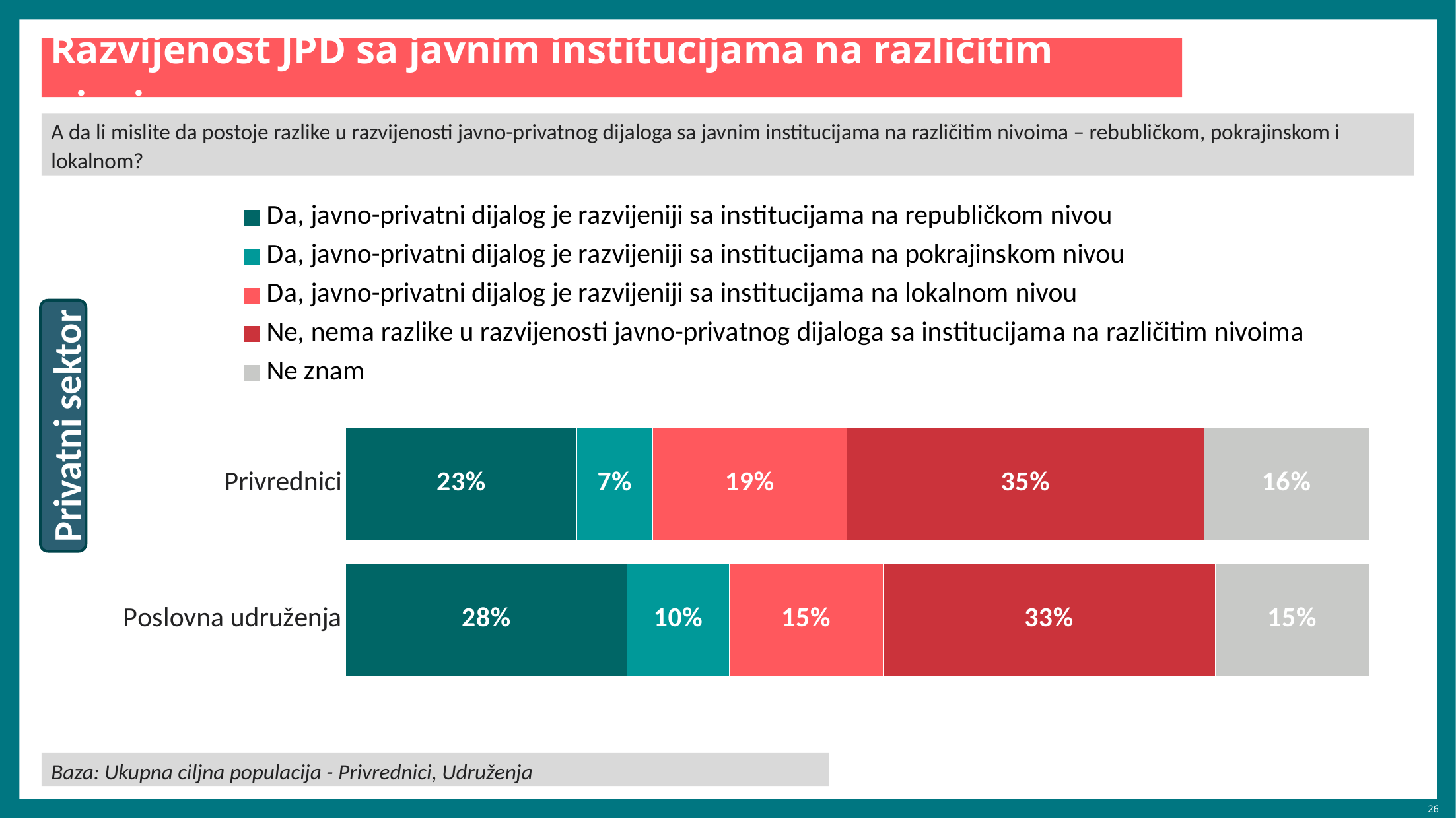
What is the value for "Da, javno-privatni dijalog je razvijeniji sa institucijama na republičkom nivou" for Poslovna udruženja? 28% What colour represents "Ne znam" in the chart? grey What is the difference between the "Ne, nema razlike..." values for Privrednici and Poslovna udruženja? 2 percentage points How many series does the legend list? 5 How many categories are plotted on the chart? 2 Which category has the larger value for "Da, javno-privatni dijalog je razvijeniji sa institucijama na lokalnom nivou"? Privrednici Which response has the highest value for Privrednici? Ne, nema razlike u razvijenosti javno-privatnog dijaloga sa institucijama na različitim nivoima What is the total of the stacked bar for Privrednici? 100% What is the value for "Da, javno-privatni dijalog je razvijeniji sa institucijama na pokrajinskom nivou" for Privrednici? 7% What is the value for "Ne znam" for Privrednici? 16% Which response has the lowest value for Poslovna udruženja? Da, javno-privatni dijalog je razvijeniji sa institucijama na pokrajinskom nivou What kind of chart is shown on the slide? stacked bar chart